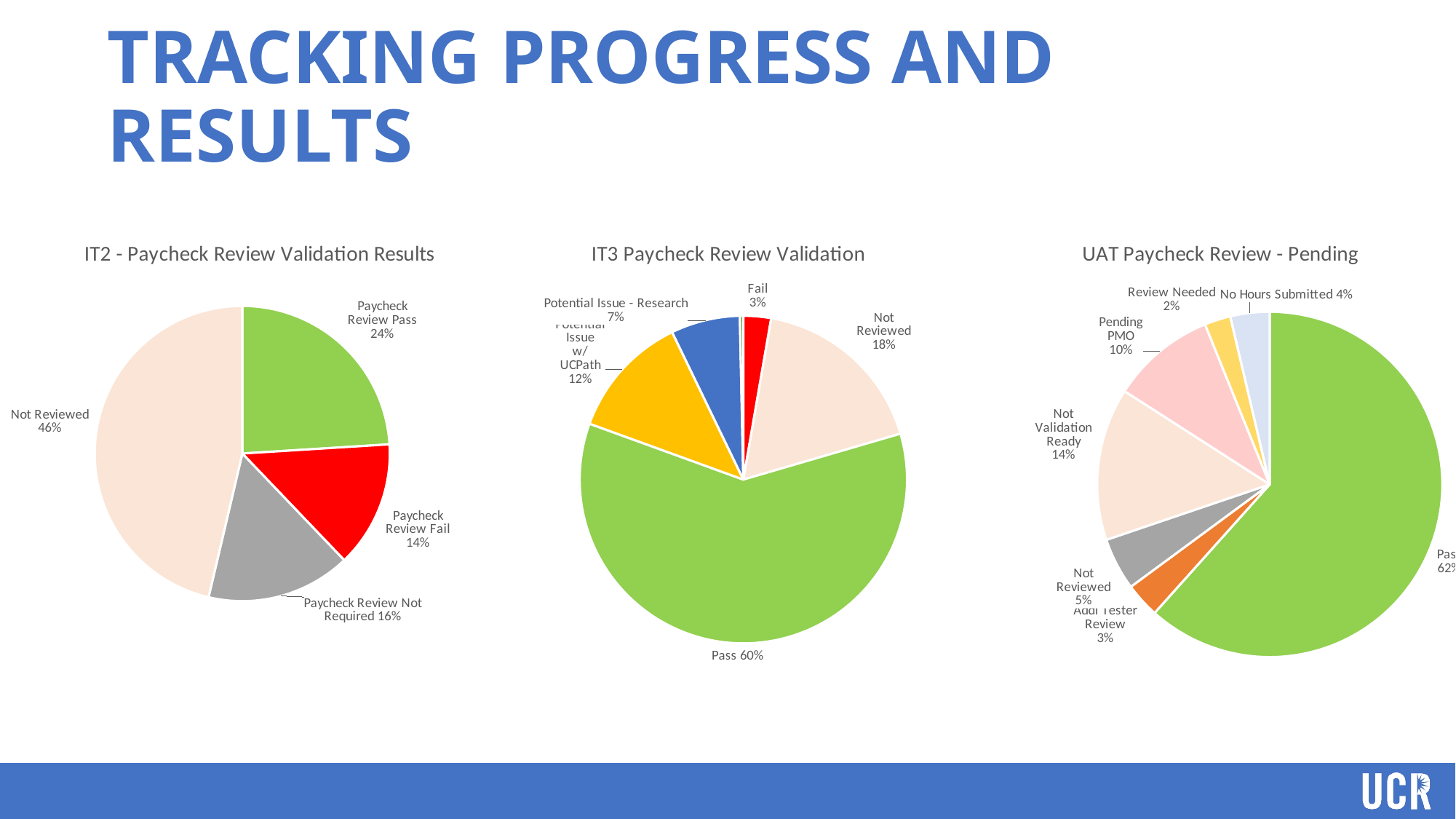
In the UAT Paycheck Review - Pending chart, what share is Not Validation Ready? 14% In the IT3 Paycheck Review Validation chart, what share is Potential Issue w/ UCPath? 12% In the UAT Paycheck Review - Pending chart, which category has the smallest slice? Review Needed In the IT2 - Paycheck Review Validation Results chart, what share is Paycheck Review Fail? 14% In the IT3 Paycheck Review Validation chart, what share is Pass? 60% In the IT2 - Paycheck Review Validation Results chart, what share is Not Reviewed? 46% In the UAT Paycheck Review - Pending chart, what is the difference between Pending PMO and No Hours Submitted? 6% In the IT3 Paycheck Review Validation chart, which is larger, Not Reviewed or Potential Issue - Research? Not Reviewed What type of chart is used for the UAT Paycheck Review - Pending chart? Pie chart In the IT2 - Paycheck Review Validation Results chart, which category has the largest slice? Not Reviewed In the IT2 - Paycheck Review Validation Results chart, how many slices does the pie have? 4 In the IT2 - Paycheck Review Validation Results chart, what is the difference between Paycheck Review Pass and Paycheck Review Fail? 10%